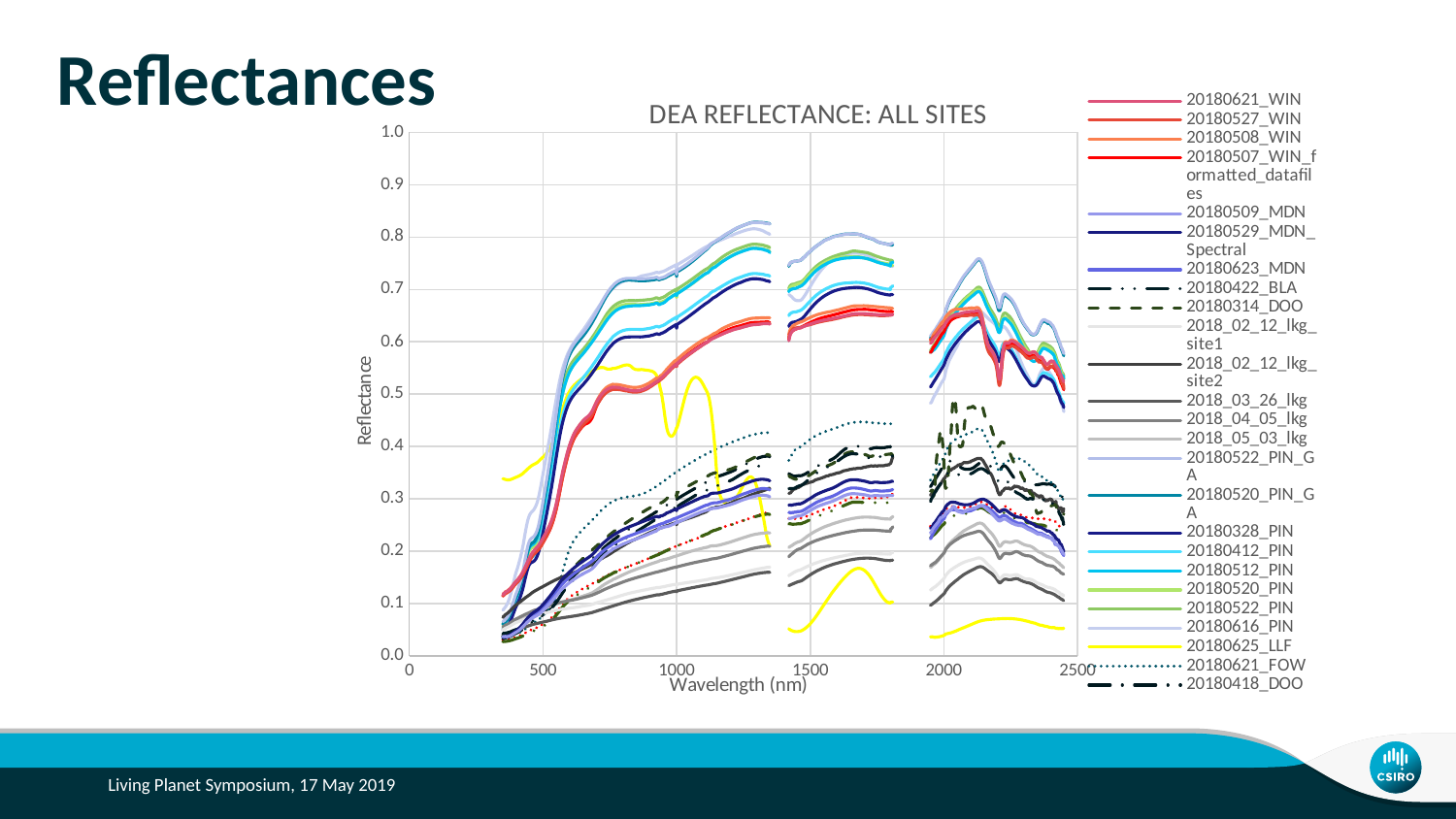
What is the label of the x axis of the chart? Wavelength (nm) How many series does the chart's legend list? 25 Into how many separate wavelength segments are the plotted lines broken? 3 Is the value for 20180625_LLF at around 2200 nm greater or less than 0.1? less Do the reflectance values for most series rise or fall between 500 nm and 1300 nm? rise What is the title of the chart? DEA REFLECTANCE: ALL SITES Is the value for 20180621_FOW at around 1700 nm greater or less than 0.4? greater What type of chart is shown on the slide? line chart Is the value for 20180625_LLF at around 1700 nm greater or less than 0.2? less